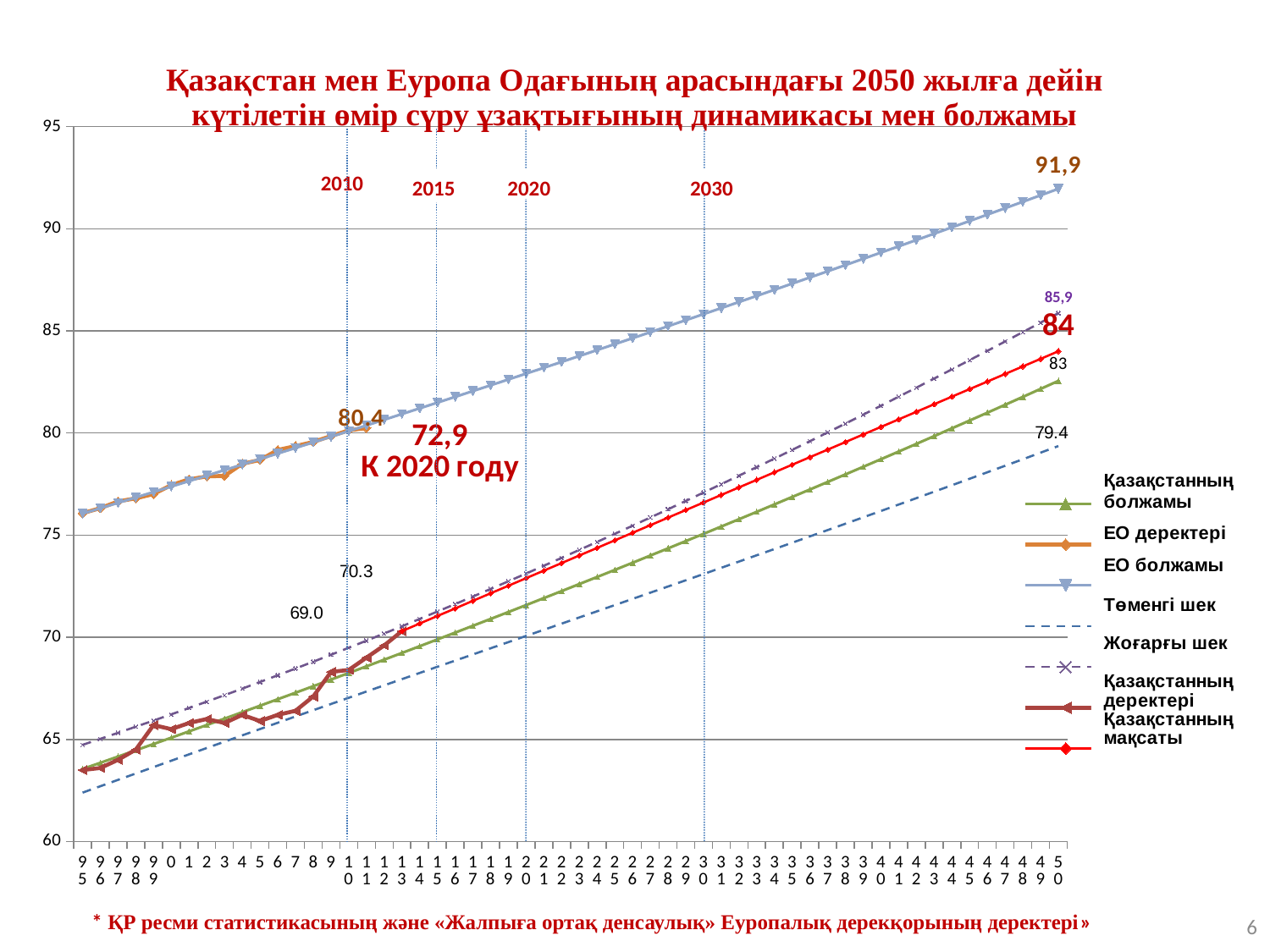
What value is labelled for Жоғарғы шек at 2050? 85,9 What value is labelled at the end of the ЕО болжамы line in 2050? 91,9 What value is labelled for Төменгі шек at 2050? 79.4 What kind of chart is shown on the slide? line chart Is the value of Қазақстанның деректері in 1995 greater or less than 65? less Which series has the highest value in 2050? ЕО болжамы How many series does the legend list? 7 Do the values of the ЕО болжамы line rise or fall from 2010 to 2050? rise What value is labelled for the ЕО деректері line at 2010? 80.4 What value is labelled for Қазақстанның мақсаты at 2050? 84 Which series has the lowest value in 2050? Төменгі шек What is the difference between the ЕО болжамы value (91,9) and the Жоғарғы шек value (85,9) in 2050? 6